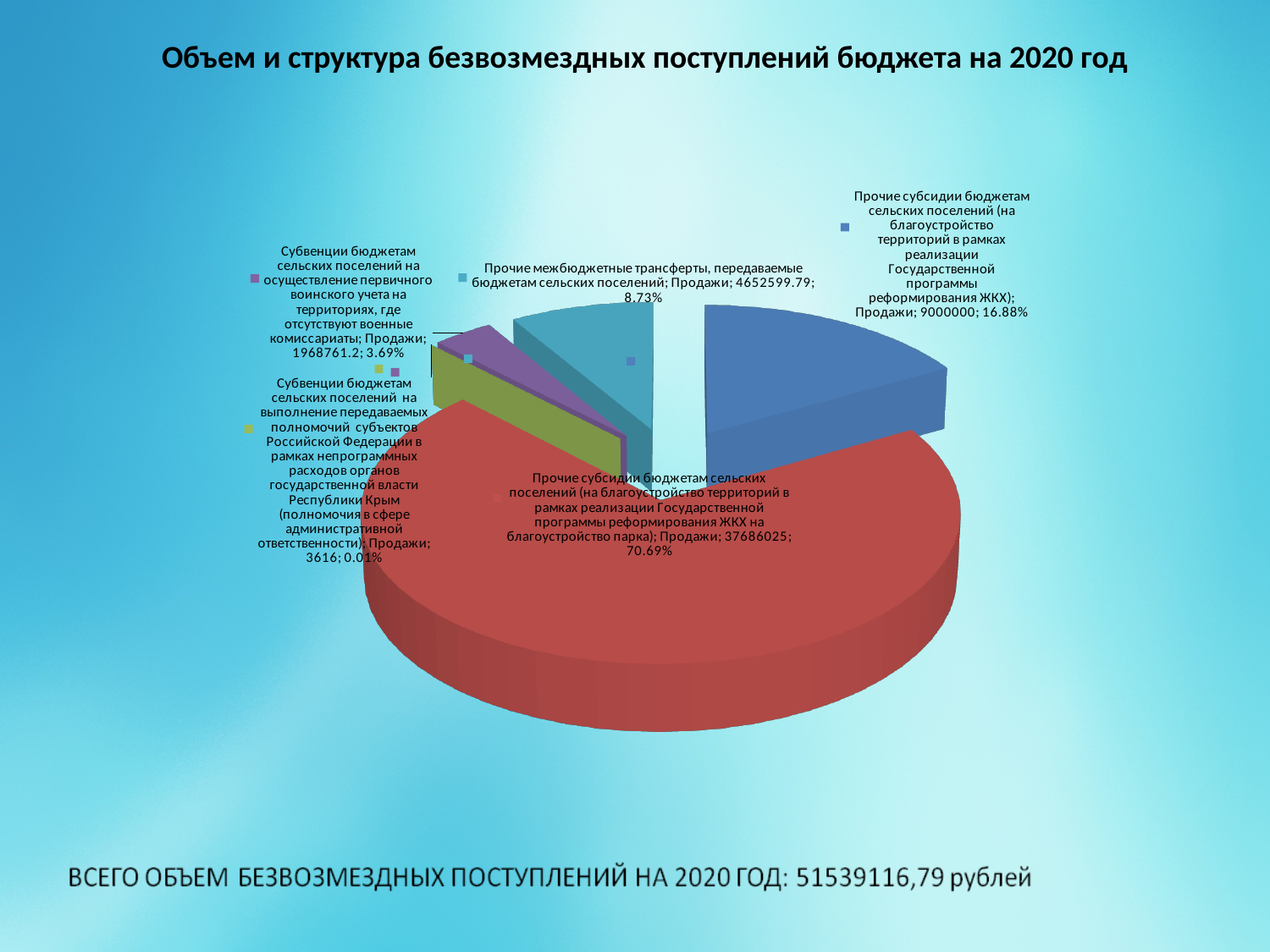
What percentage share is shown for the slice 'Прочие субсидии бюджетам сельских поселений (на благоустройство территорий ... на благоустройство парка)'? 70.69% What kind of chart is shown on the slide? pie chart What is the percentage share of the smallest slice? 0.01% Which category has the smallest slice of the pie? Субвенции бюджетам сельских поселений на выполнение передаваемых полномочий субъектов Российской Федерации (полномочия в сфере административной ответственности) What is the title of the chart on the slide? Объем и структура безвозмездных поступлений бюджета на 2020 год What is the value for 'Прочие межбюджетные трансферты, передаваемые бюджетам сельских поселений'? 4652599.79 Which category has the largest slice of the pie? Прочие субсидии бюджетам сельских поселений (на благоустройство территорий в рамках реализации Государственной программы реформирования ЖКХ на благоустройство парка) What is the value for the slice 'Прочие субсидии бюджетам сельских поселений (на благоустройство территорий в рамках реализации Государственной программы реформирования ЖКХ)' (the one without 'на благоустройство парка')? 9000000 What is the value for 'Субвенции бюджетам сельских поселений на осуществление первичного воинского учета на территориях, где отсутствуют военные комиссариаты'? 1968761.2 How many slices does the pie chart have? 5 What percentage share is shown for 'Прочие межбюджетные трансферты, передаваемые бюджетам сельских поселений'? 8.73% Which is larger: the value for 'Прочие межбюджетные трансферты' or the value for 'Субвенции ... на осуществление первичного воинского учета'? Прочие межбюджетные трансферты